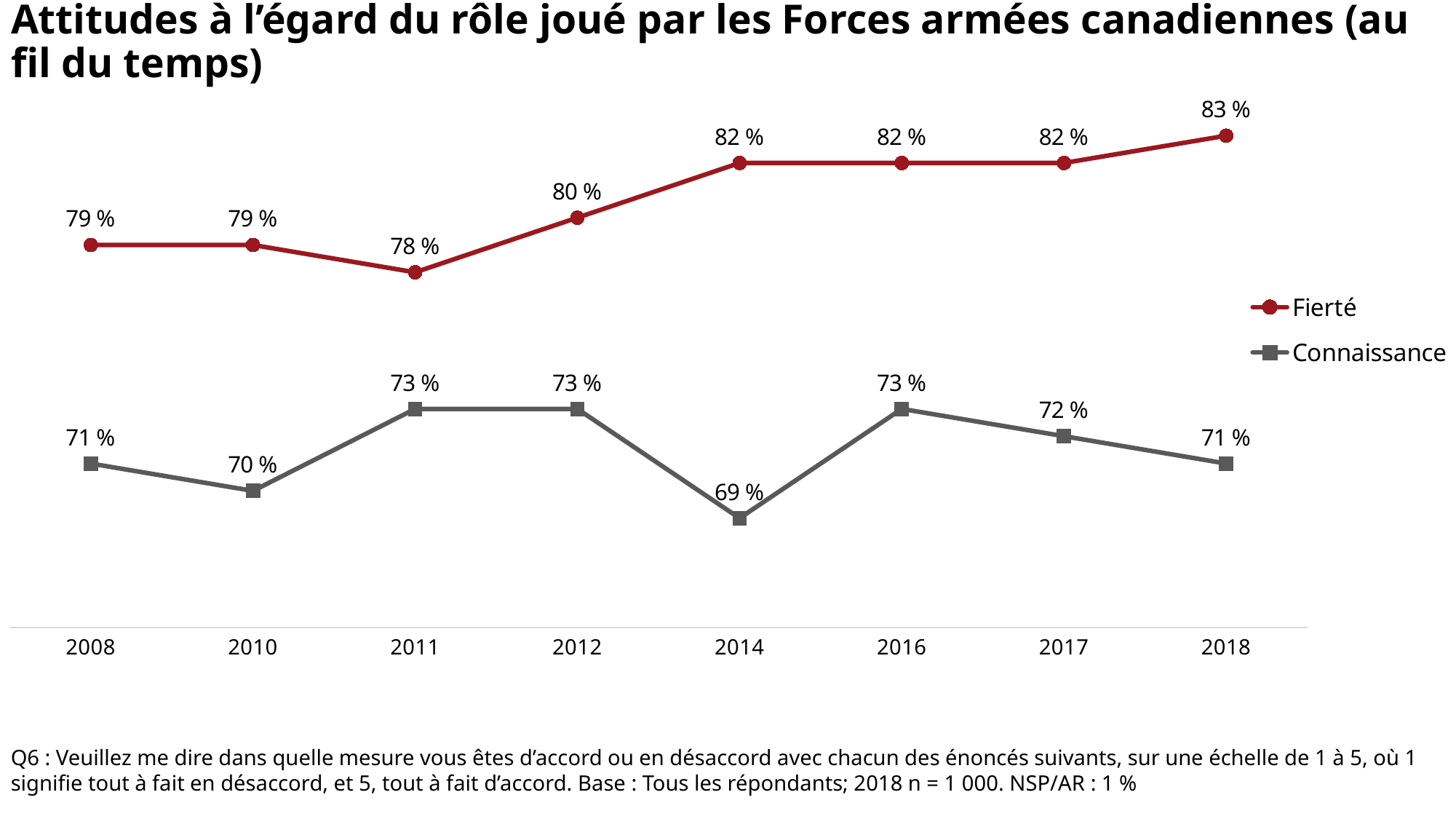
What is the Fierté value for 2012? 80 % What is the difference between the Fierté and Connaissance values in 2018? 12 % Which is larger in 2011: the Fierté value or the Connaissance value? Fierté What is the Connaissance value for 2014? 69 % What is the Fierté value for 2018? 83 % What kind of chart is shown on the slide? Line chart In which year is the Connaissance series lowest? 2014 In which year is the Fierté series highest? 2018 How many series does the legend list? 2 How many years are plotted on the x axis? 8 Does the Fierté series rise or fall from 2012 to 2018? Rise What colour is the Fierté line? Red